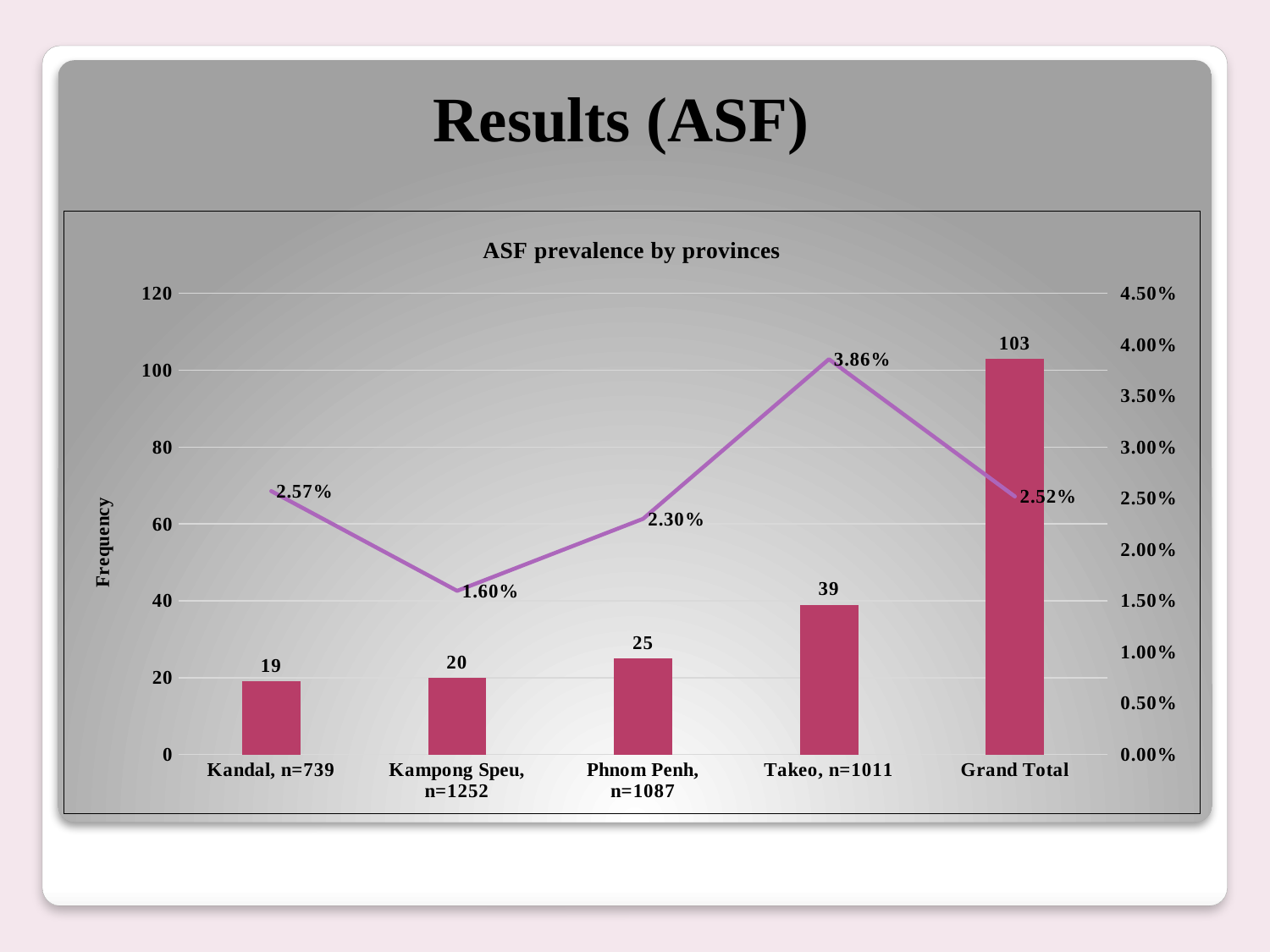
What kind of chart is this? Combined bar and line chart What is the label of the left vertical axis? Frequency Which province has the highest prevalence percentage on the line? Takeo, n=1011 Which has a higher prevalence percentage, Kandal, n=739 or Phnom Penh, n=1087? Kandal, n=739 How many categories are shown on the x axis? 5 What is the frequency value for Grand Total? 103 What is the frequency value for Takeo, n=1011? 39 What is the prevalence percentage shown for Kampong Speu, n=1252? 1.60% What is the prevalence percentage shown for Phnom Penh, n=1087? 2.30% What is the title of the chart? ASF prevalence by provinces Which category has the lowest frequency bar? Kandal, n=739 What is the difference in frequency between Takeo, n=1011 and Phnom Penh, n=1087? 14